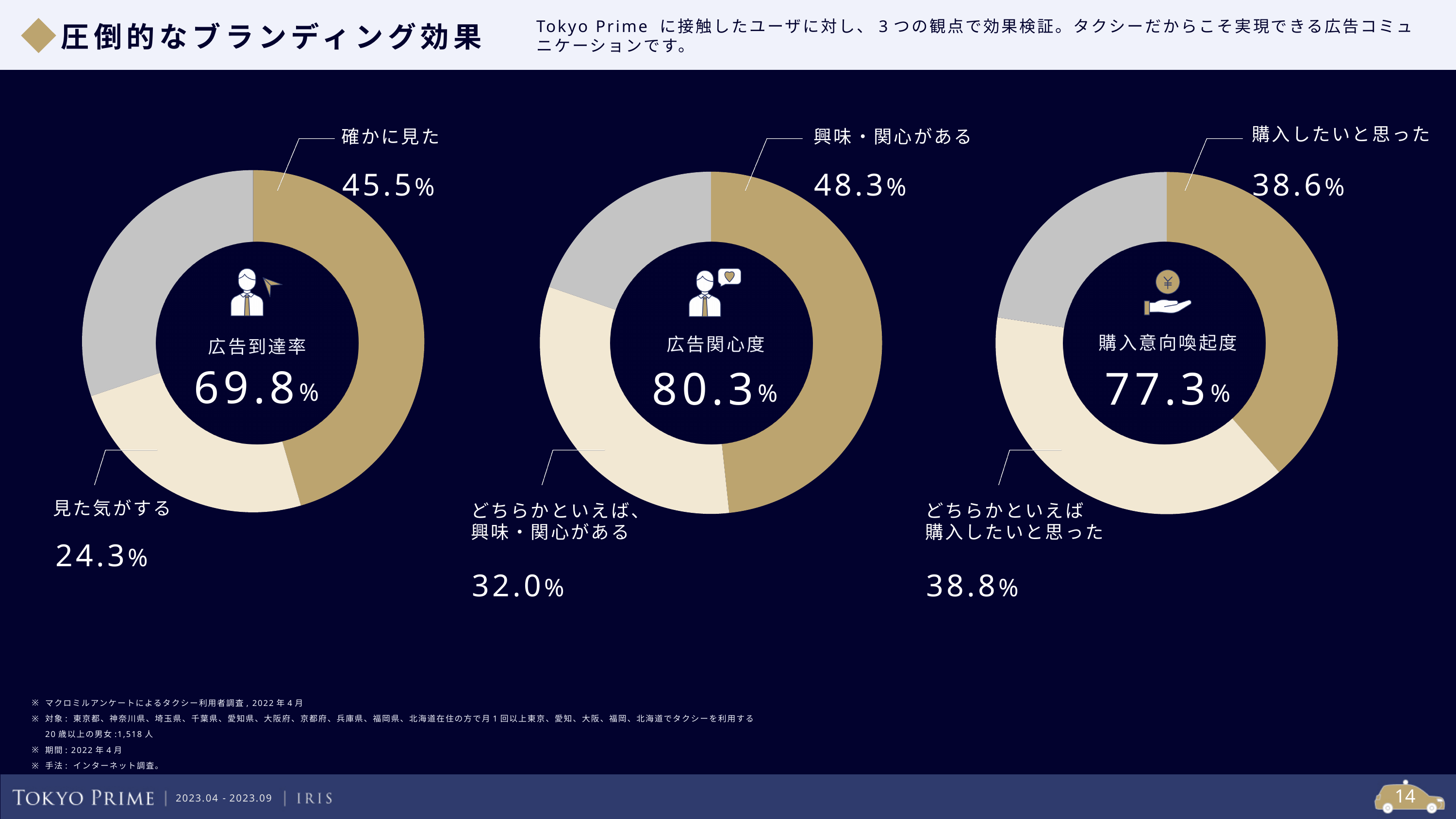
Which of the three charts shows the highest centre percentage? 広告関心度 In the 広告関心度 chart, what is the value for 興味・関心がある? 48.3% In the 広告到達率 chart, which is larger, 確かに見た or 見た気がする? 確かに見た In the 広告到達率 chart, what is the value for 確かに見た? 45.5% What kind of chart is used for 広告到達率? Donut chart In the 購入意向喚起度 chart, what is the difference between どちらかといえば購入したいと思った and 購入したいと思った? 0.2% What total percentage is shown in the centre of the 広告関心度 chart? 80.3% In the 広告関心度 chart, what is the difference between 興味・関心がある and どちらかといえば、興味・関心がある? 16.3% What is the combined value of 確かに見た and 見た気がする in the 広告到達率 chart? 69.8% In the 広告到達率 chart, what is the value for 見た気がする? 24.3% In the 購入意向喚起度 chart, what is the value for どちらかといえば購入したいと思った? 38.8% How many donut charts are shown on the slide? 3